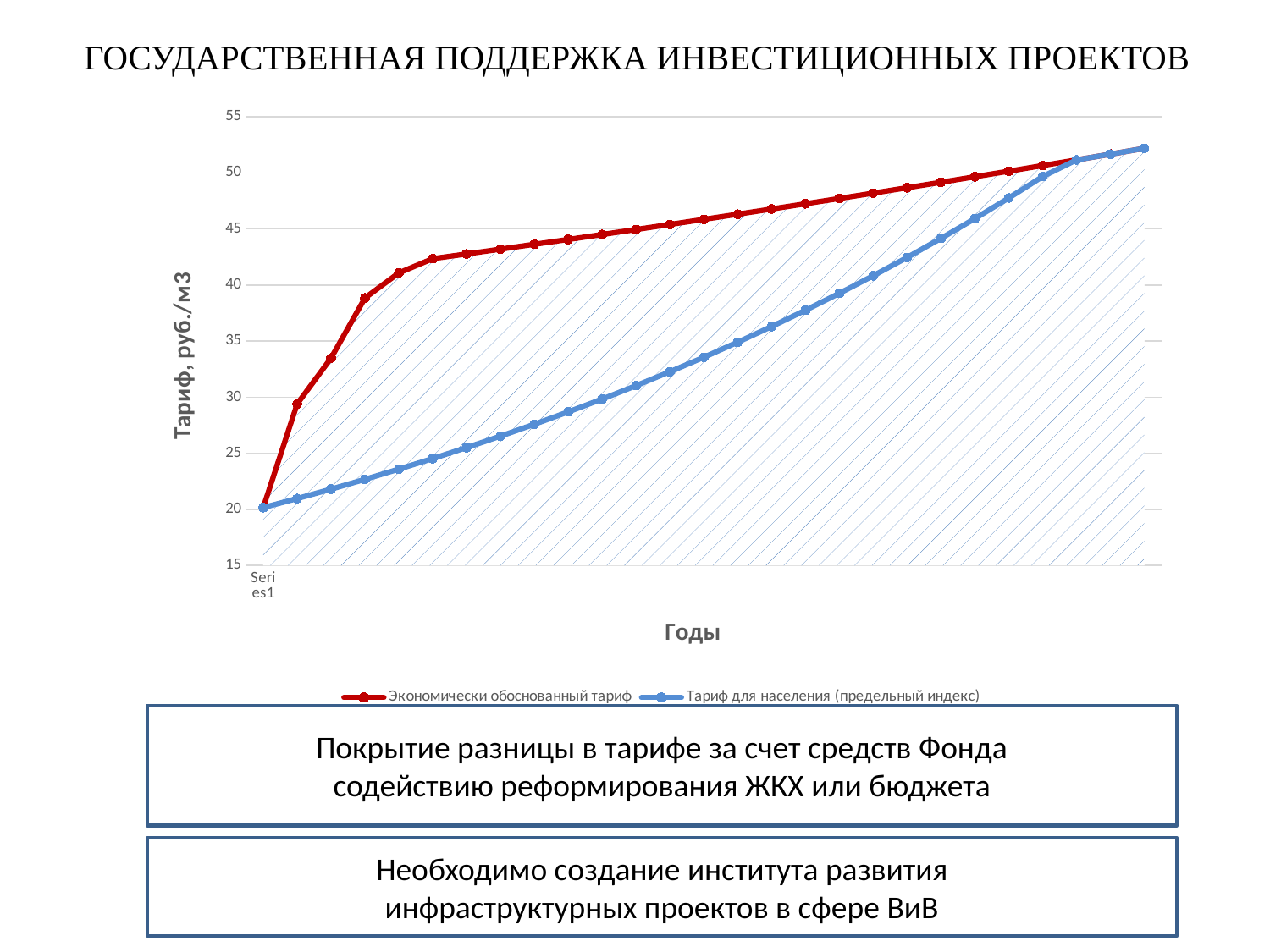
What is the label of the blue series in the legend? Тариф для населения (предельный индекс) What kind of chart is shown on the slide? line chart How many series does the chart legend list? 2 Is the starting value of the series 'Тариф для населения (предельный индекс)' greater or less than 25? less Do the values of the series 'Экономически обоснованный тариф' rise or fall along the x axis? rise Do the values of the series 'Тариф для населения (предельный индекс)' rise or fall along the x axis? rise Which series has the higher values across the middle of the chart, 'Экономически обоснованный тариф' or 'Тариф для населения (предельный индекс)'? Экономически обоснованный тариф What is the label of the red series in the legend? Экономически обоснованный тариф Is the final value of the series 'Тариф для населения (предельный индекс)' greater or less than 50? greater Is the starting value of the series 'Экономически обоснованный тариф' greater or less than 25? less